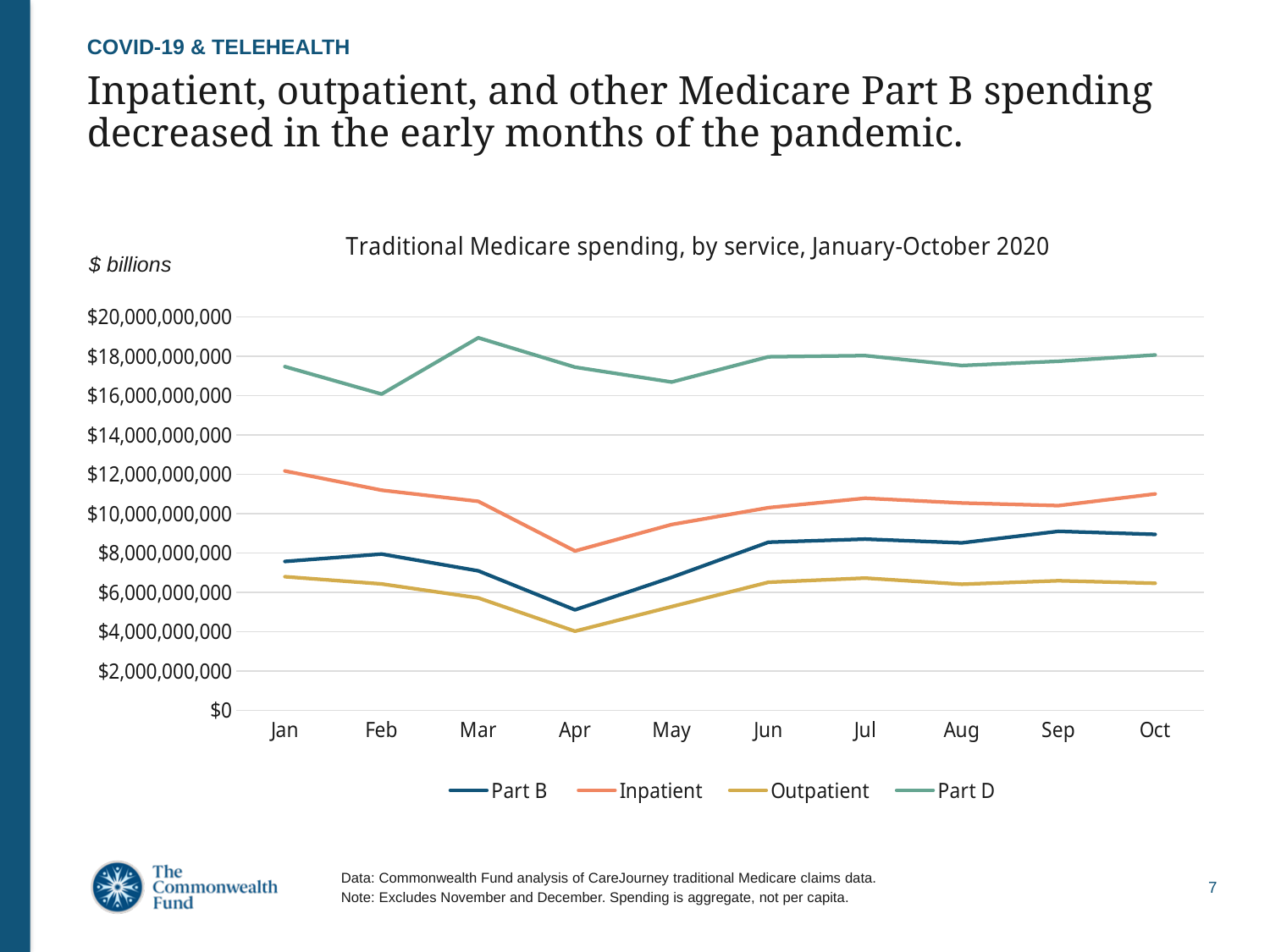
In Jan, which is larger: Inpatient spending or Part B spending? Inpatient In which month is Part D spending lowest? Feb Does Inpatient spending rise or fall from Jan to Apr? fall What is the title of the chart? Traditional Medicare spending, by service, January-October 2020 Is the value for Part D in Mar greater or less than $18,000,000,000? greater What kind of chart is shown on the slide? line chart How many months are plotted along the x axis? 10 In which month is Inpatient spending lowest? Apr How many series does the legend list? 4 Is the value for Inpatient in Apr greater or less than $10,000,000,000? less Is the value for Outpatient in Apr greater or less than $6,000,000,000? less In which month is Part D spending highest? Mar